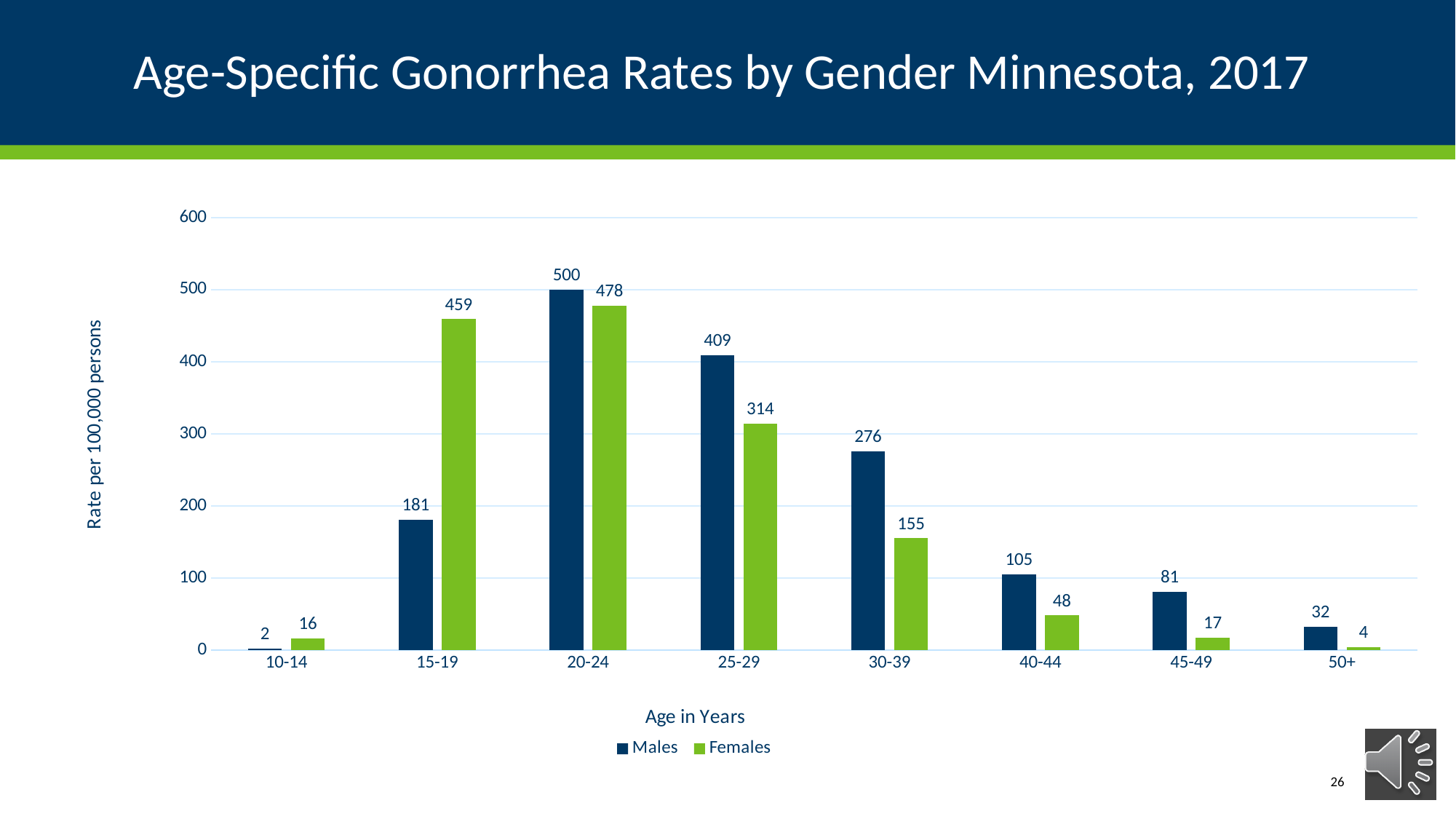
How many series does the legend list? 2 What is the difference between the male and female rates in the 25-29 age group? 95 What is the label of the y axis? Rate per 100,000 persons What is the gonorrhea rate for females aged 15-19? 459 Is the male rate for the 30-39 age group greater or less than 200? greater Which age group has the lowest rate for males? 10-14 How many age groups are shown on the x axis? 8 Which age group has the highest rate for females? 20-24 What kind of chart is shown on the slide? Bar chart What is the gonorrhea rate for males aged 20-24? 500 What is the gonorrhea rate for females aged 50+? 4 In the 15-19 age group, which is higher, the male rate or the female rate? Females